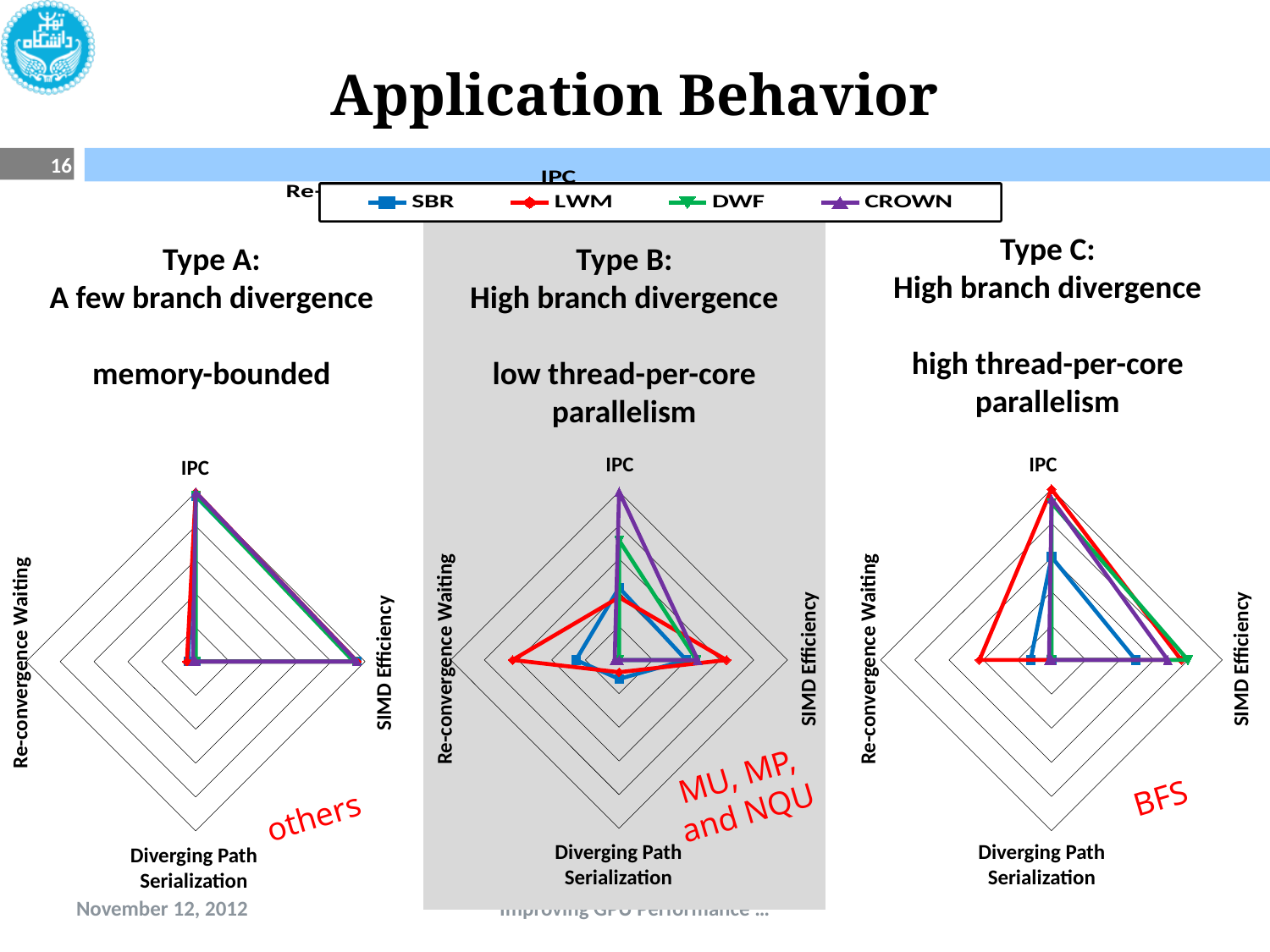
Which series are listed in the legend? SBR, LWM, DWF, CROWN In the Type C chart, which series has the highest Re-convergence Waiting? LWM In the Type C chart, which is larger for IPC, LWM or SBR? LWM How many series does the legend at the top of the slide list? 4 In the Type B (High branch divergence, low thread-per-core parallelism) chart, which series has the highest IPC? CROWN In the Type C chart, which is larger for SIMD Efficiency, DWF or SBR? DWF How many axes (categories) does each radar chart have? 4 In the Type B chart, which series has the highest Re-convergence Waiting? LWM In the Type B chart, which is larger for IPC, CROWN or SBR? CROWN What colour is used for the CROWN series? Purple In the Type C (High branch divergence, high thread-per-core parallelism) chart, which series has the lowest IPC? SBR What kind of chart is used for the Type A, Type B and Type C panels on this slide? Radar chart